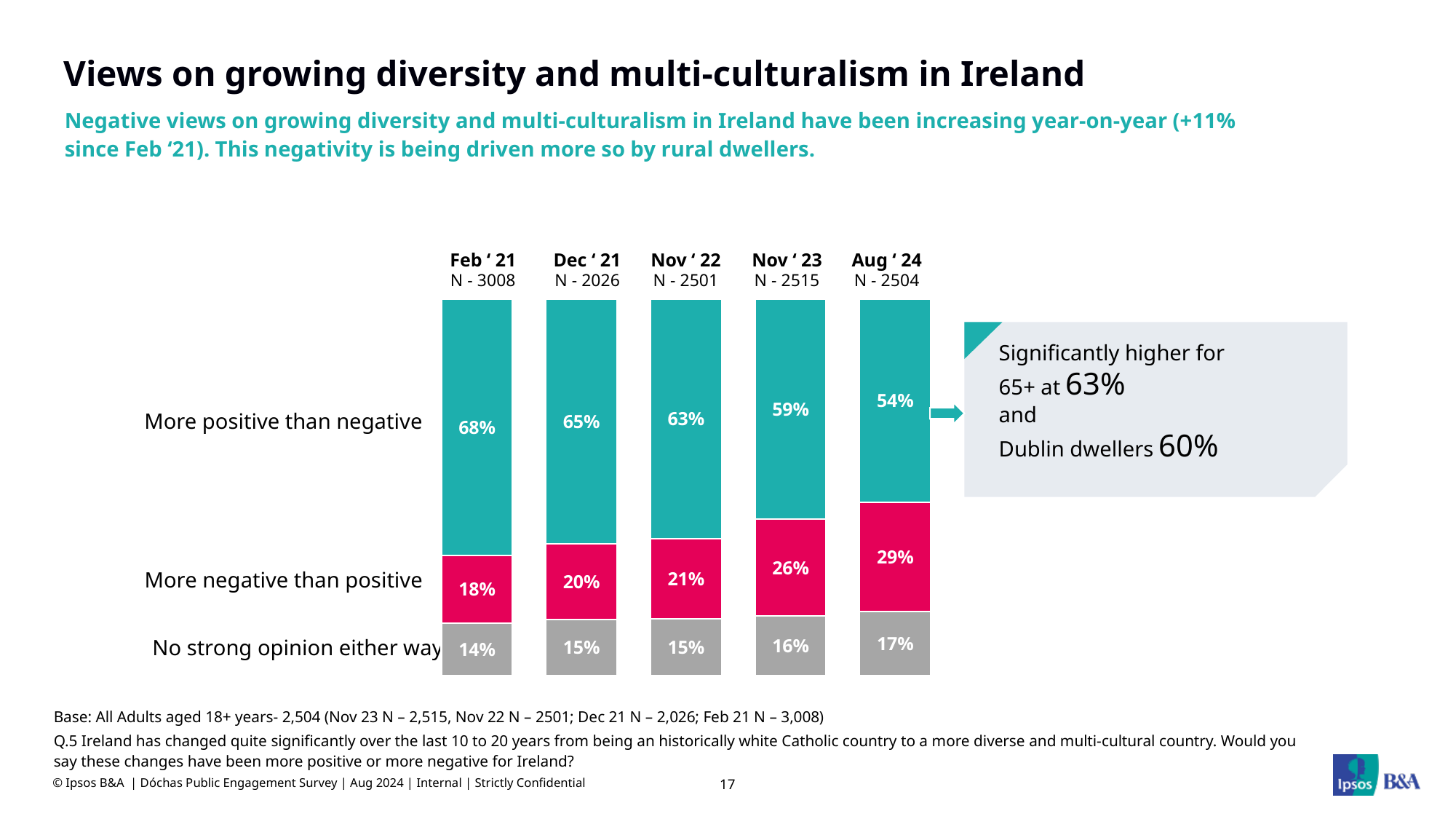
In which survey wave was 'More negative than positive' lowest? Feb '21 How many response categories are shown for each bar? 3 What kind of chart is shown on the slide? Stacked bar chart Which is larger: 'More positive than negative' in Nov '23 or in Aug '24? Nov '23 By how many percentage points did 'More negative than positive' change from Feb '21 to Aug '24? 11 percentage points What percentage of respondents were 'More negative than positive' in Feb '21? 18% How does 'More positive than negative' change across the survey waves from Feb '21 to Aug '24? It falls How many survey waves are shown in the chart? 5 What percentage of respondents were 'More positive than negative' in Aug '24? 54% What is the sample size (N) for the Dec '21 wave? 2026 In which survey wave was 'More positive than negative' highest? Feb '21 What percentage had 'No strong opinion either way' in Nov '22? 15%